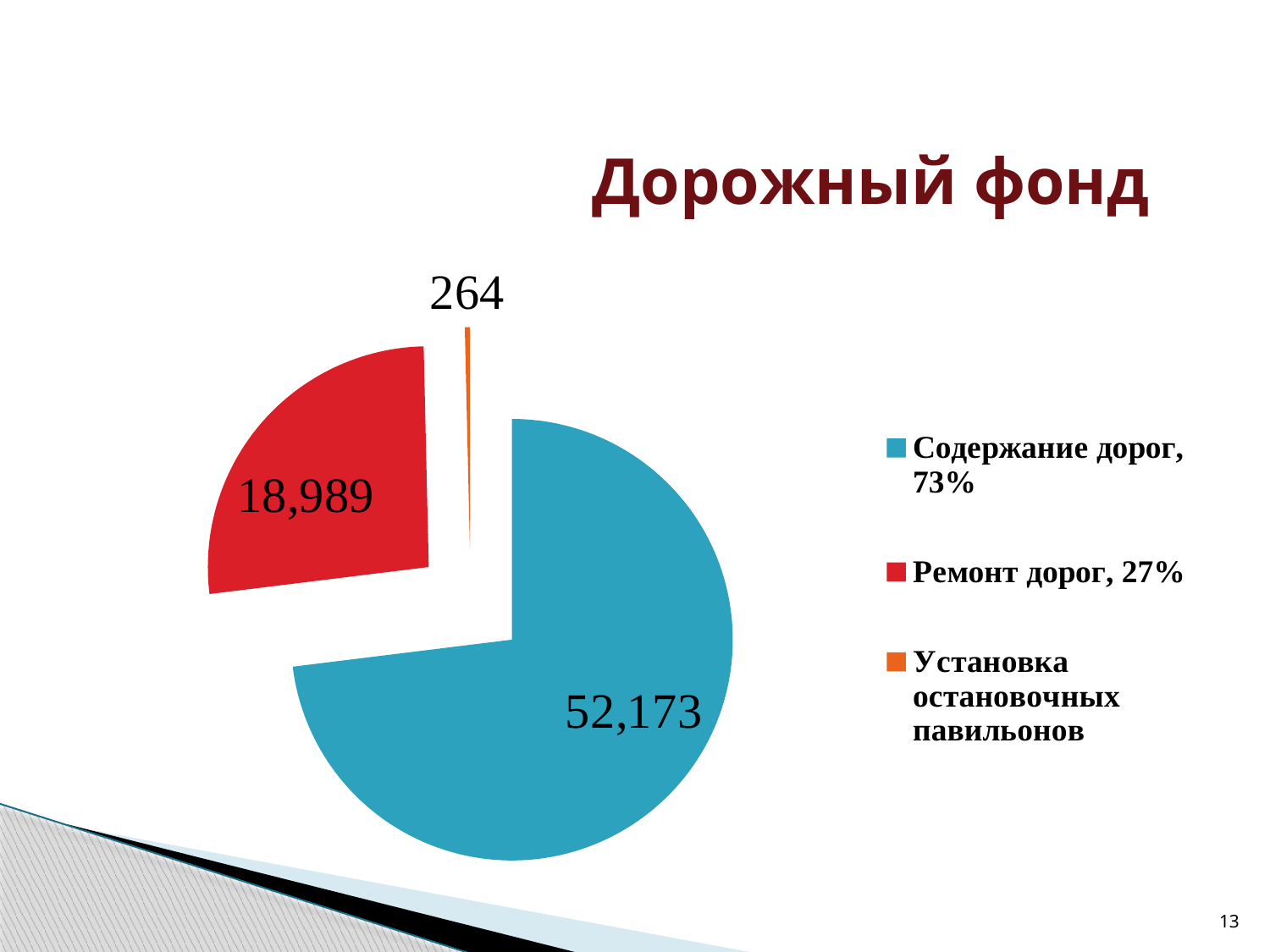
Which category has the largest slice of the pie? Содержание дорог What kind of chart is shown on the slide? Pie chart Which category has the smallest slice of the pie? Установка остановочных павильонов What share of the pie does Содержание дорог represent, according to the legend? 73% What is the value for Содержание дорог? 52,173 What is the title of the slide with the pie chart? Дорожный фонд What is the value for Установка остановочных павильонов? 264 What share of the pie does Ремонт дорог represent, according to the legend? 27% What is the value for Ремонт дорог? 18,989 What is the difference between the values for Содержание дорог and Ремонт дорог? 33,184 Which is larger, the value for Ремонт дорог or the value for Установка остановочных павильонов? Ремонт дорог How many categories does the pie chart have? 3